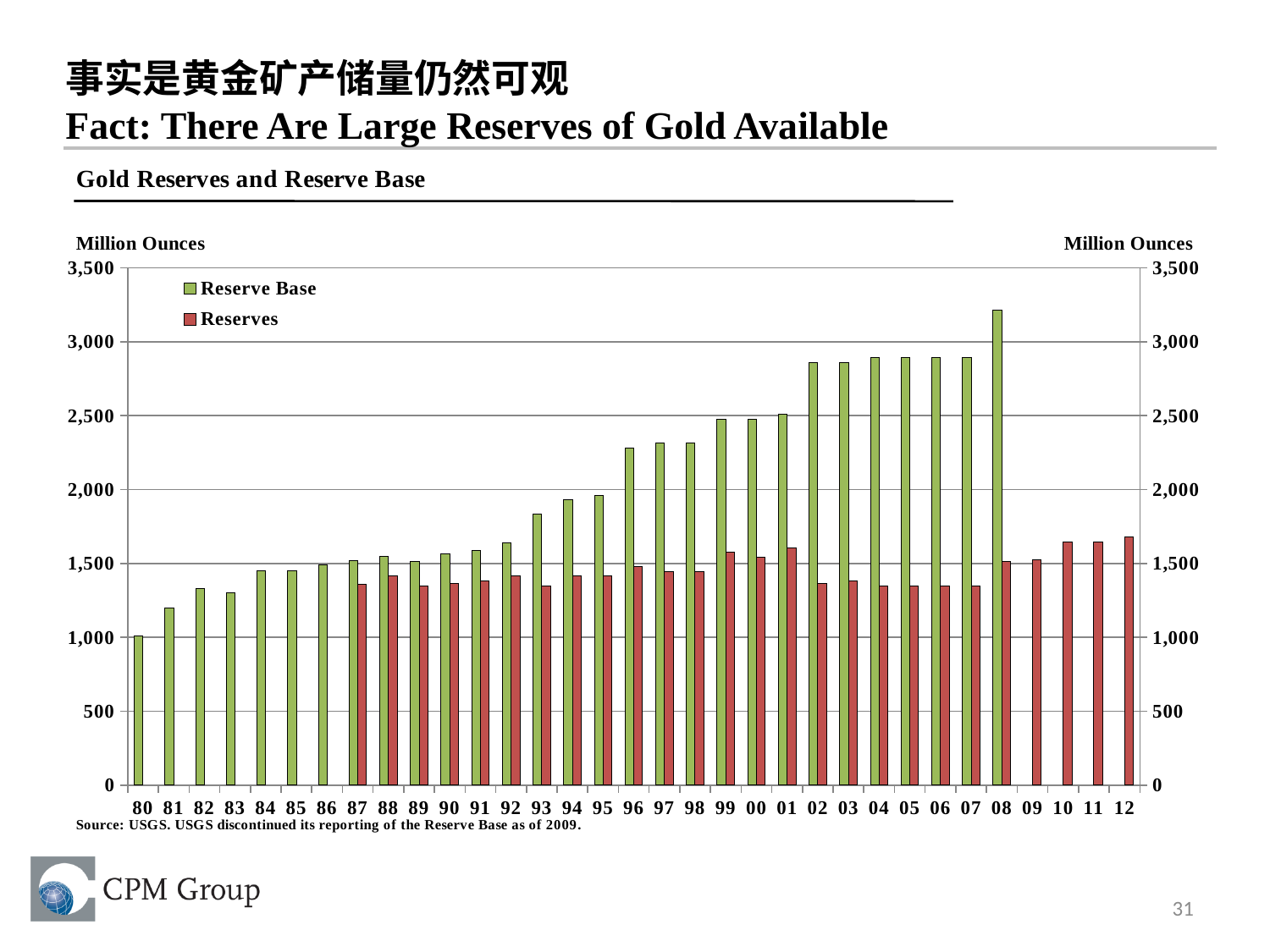
Is the Reserve Base value for 08 greater or less than 3,000? greater How many years are shown along the x axis? 33 Is the Reserves value for 02 greater or less than 1,500? less In which year is the Reserve Base highest? 08 What kind of chart is shown on the slide? bar chart Is the Reserves value for 01 greater or less than 1,500? greater In 08, which is larger, the Reserve Base or the Reserves? Reserve Base Does the Reserve Base generally rise or fall from 80 to 08? rise What unit is shown on the y axis? Million Ounces In which year is the Reserve Base lowest? 80 How many series does the legend list? 2